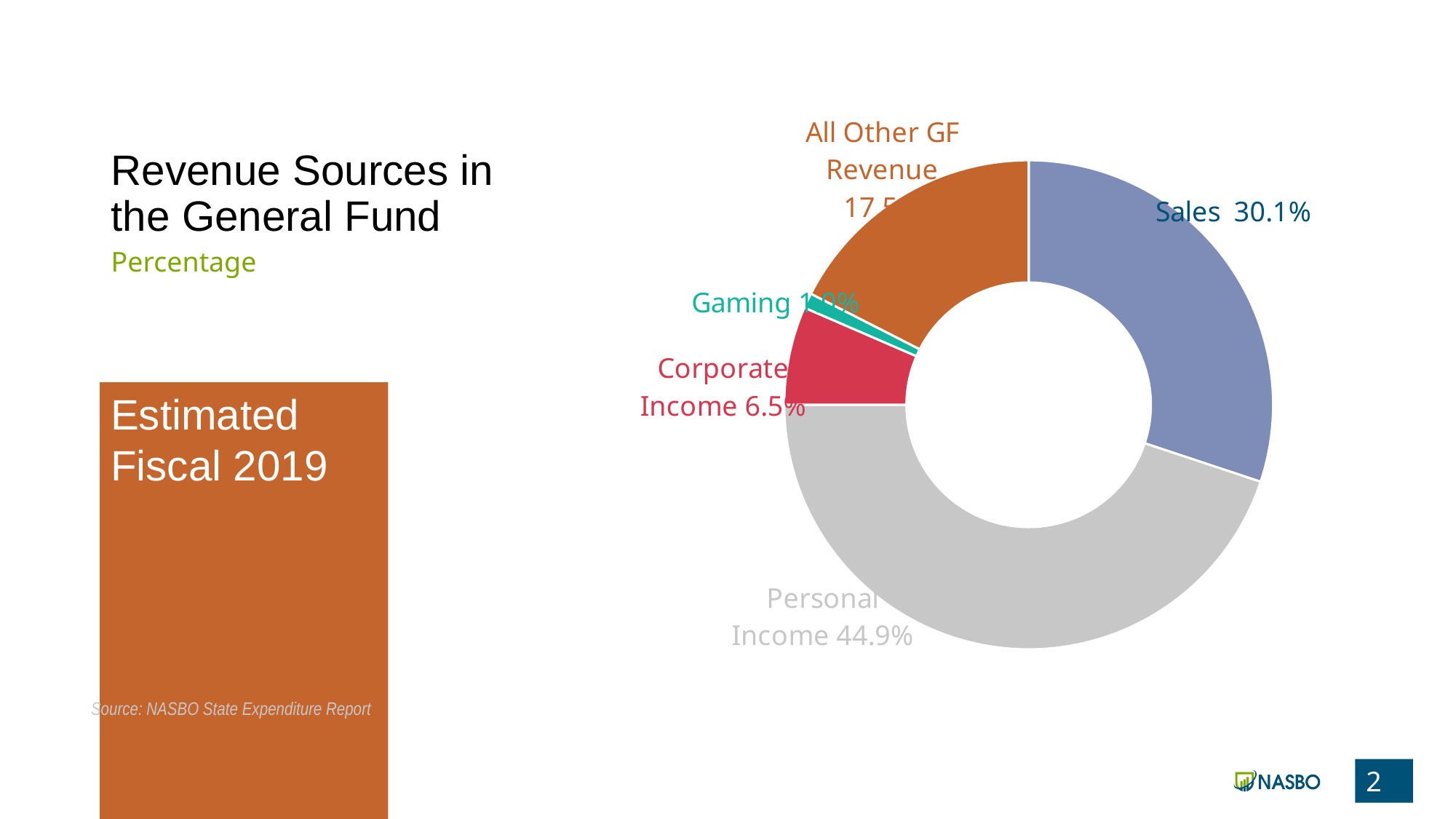
What percentage of General Fund revenue comes from Sales? 30.1% Which is larger, the share for Sales or the share for All Other GF Revenue? Sales How many revenue sources are shown in the chart? 5 Which fiscal year does the chart show estimates for? Fiscal 2019 Which revenue source has the largest share of the General Fund? Personal Income What percentage of General Fund revenue comes from Personal Income? 44.9% Which is larger, the share for Corporate Income or the share for Gaming? Corporate Income How many percentage points larger is the Sales share than the Corporate Income share? 23.6 percentage points What percentage of General Fund revenue comes from Corporate Income? 6.5% Which revenue source has the smallest share of the General Fund? Gaming How many percentage points larger is the Personal Income share than the Sales share? 14.8 percentage points What kind of chart is used to show the revenue sources? Doughnut (pie) chart